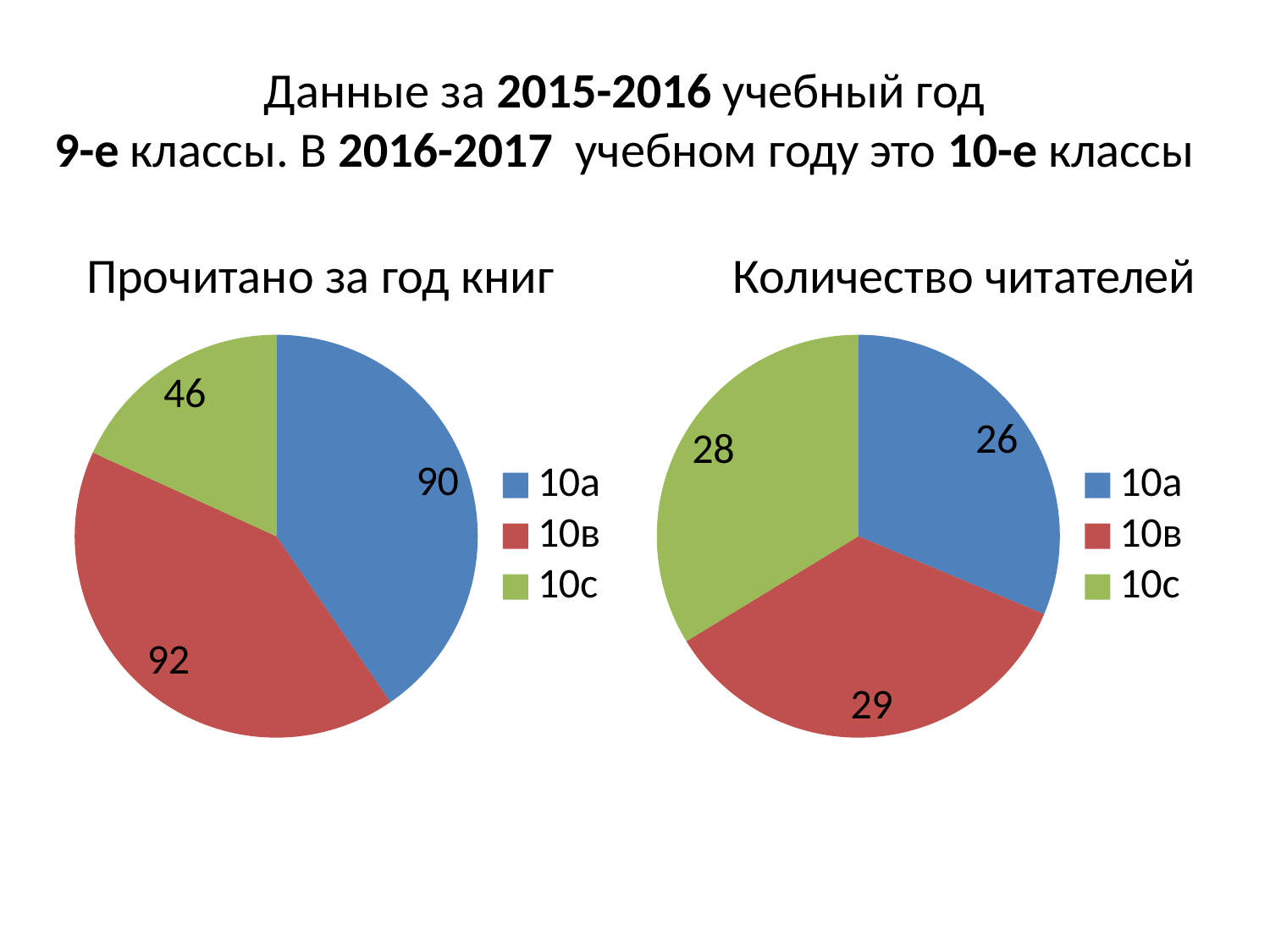
In the chart titled "Прочитано за год книг", what is the difference between the values for 10в and 10с? 46 How many slices does the chart titled "Количество читателей" have? 3 In the chart titled "Количество читателей", which class has the largest value? 10в In the chart titled "Количество читателей", what is the difference between the values for 10в and 10а? 3 In the chart titled "Прочитано за год книг", what is the value for 10в? 92 In the chart titled "Количество читателей", what is the value for 10а? 26 In the chart titled "Количество читателей", which colour represents 10с in the legend? Green In the chart titled "Прочитано за год книг", what is the value for 10с? 46 In the chart titled "Количество читателей", what is the value for 10с? 28 What type of chart is the chart titled "Прочитано за год книг"? Pie chart In the chart titled "Прочитано за год книг", which is larger: the value for 10а or the value for 10с? 10а In the chart titled "Прочитано за год книг", which class has the smallest slice? 10с